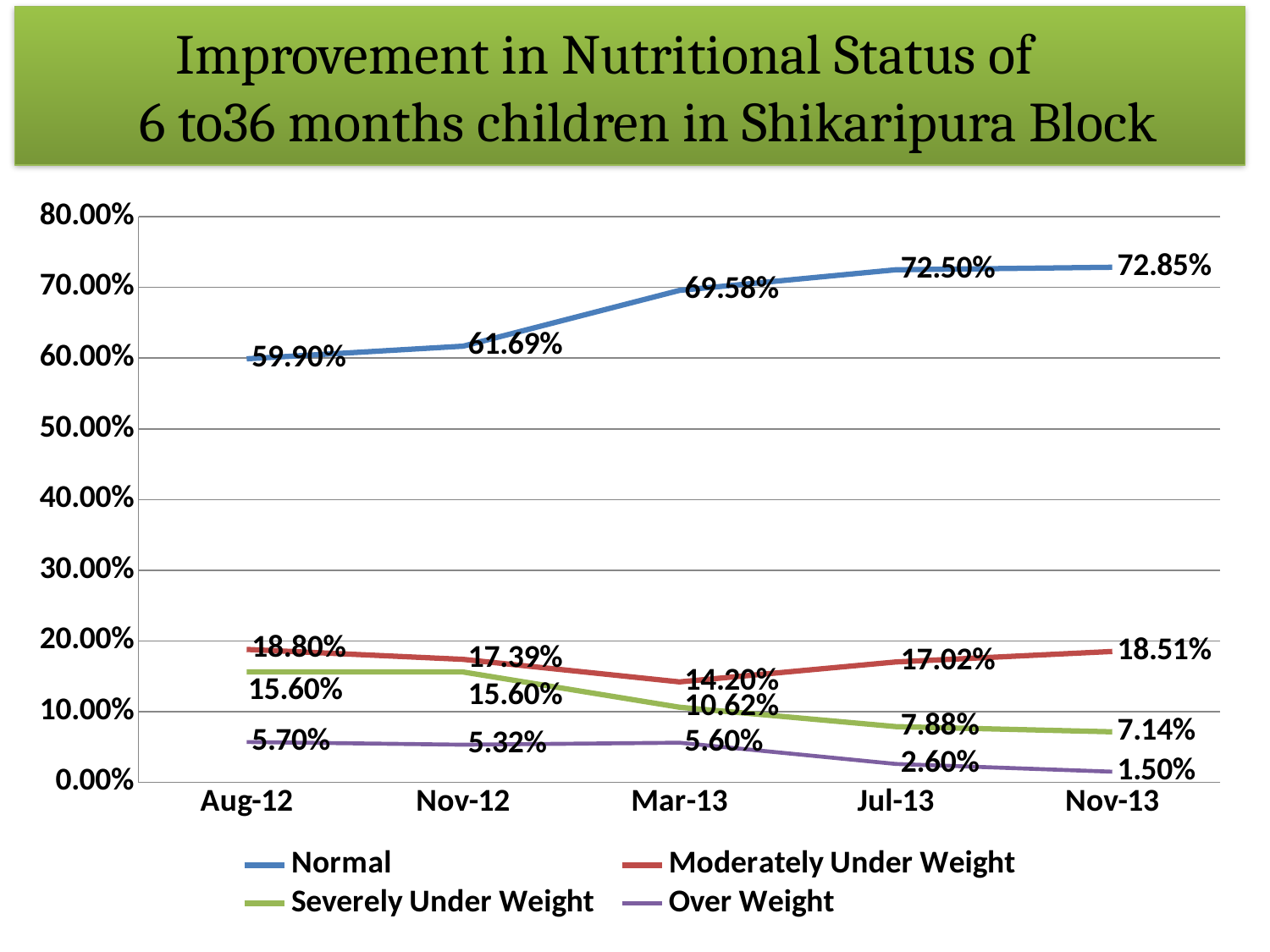
How many series does the legend list? 4 How many time points are plotted along the x axis? 5 What is the value for Over Weight in Nov-12? 5.32% At which time point is the Normal series highest? Nov-13 Does the Severely Under Weight series rise or fall from Aug-12 to Nov-13? fall What is the value for Normal in Mar-13? 69.58% At which time point is the Moderately Under Weight series lowest? Mar-13 What kind of chart is shown on the slide? line chart What is the difference between the Normal value in Nov-13 and in Aug-12? 12.95% Which is larger in Mar-13: Moderately Under Weight or Severely Under Weight? Moderately Under Weight What is the value for Severely Under Weight in Jul-13? 7.88% What is the value for Moderately Under Weight in Nov-13? 18.51%